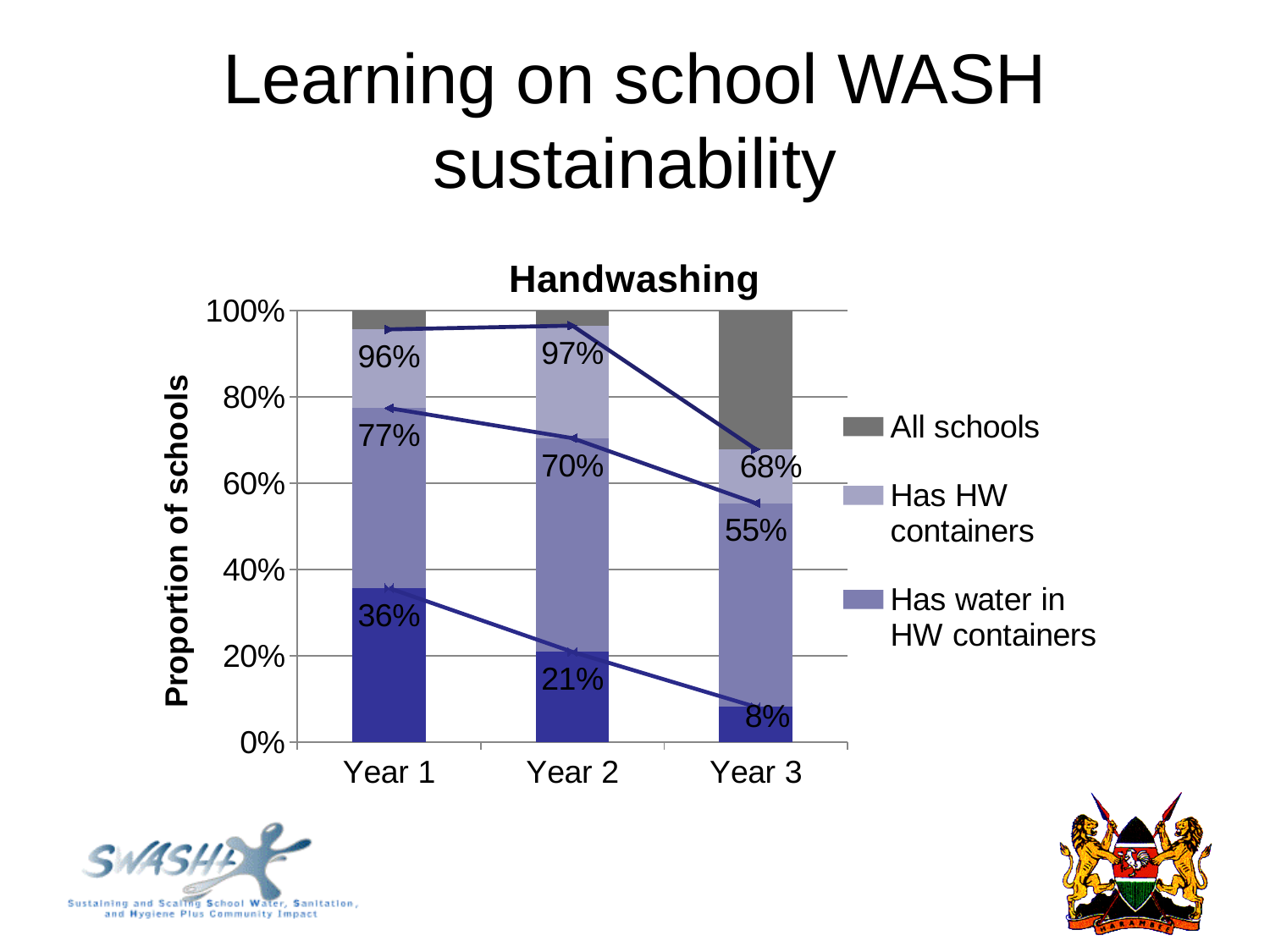
What is the value for 'Has HW containers' in Year 2? 97% How many years are shown on the x axis? 3 Does the 'Has water in HW containers' value rise or fall from Year 1 to Year 3? fall What is the difference between the 'Has HW containers' values in Year 1 and Year 3? 28% In which year is the 'All schools' value highest? Year 3 What is the title of the chart? Handwashing What is the value for 'Has water in HW containers' in Year 3? 55% In which year is the 'Has water in HW containers' value lowest? Year 3 Which is larger: 'Has water in HW containers' in Year 1 or in Year 2? Year 1 What is the value for 'Has HW containers' in Year 3? 68% How many series does the legend list? 3